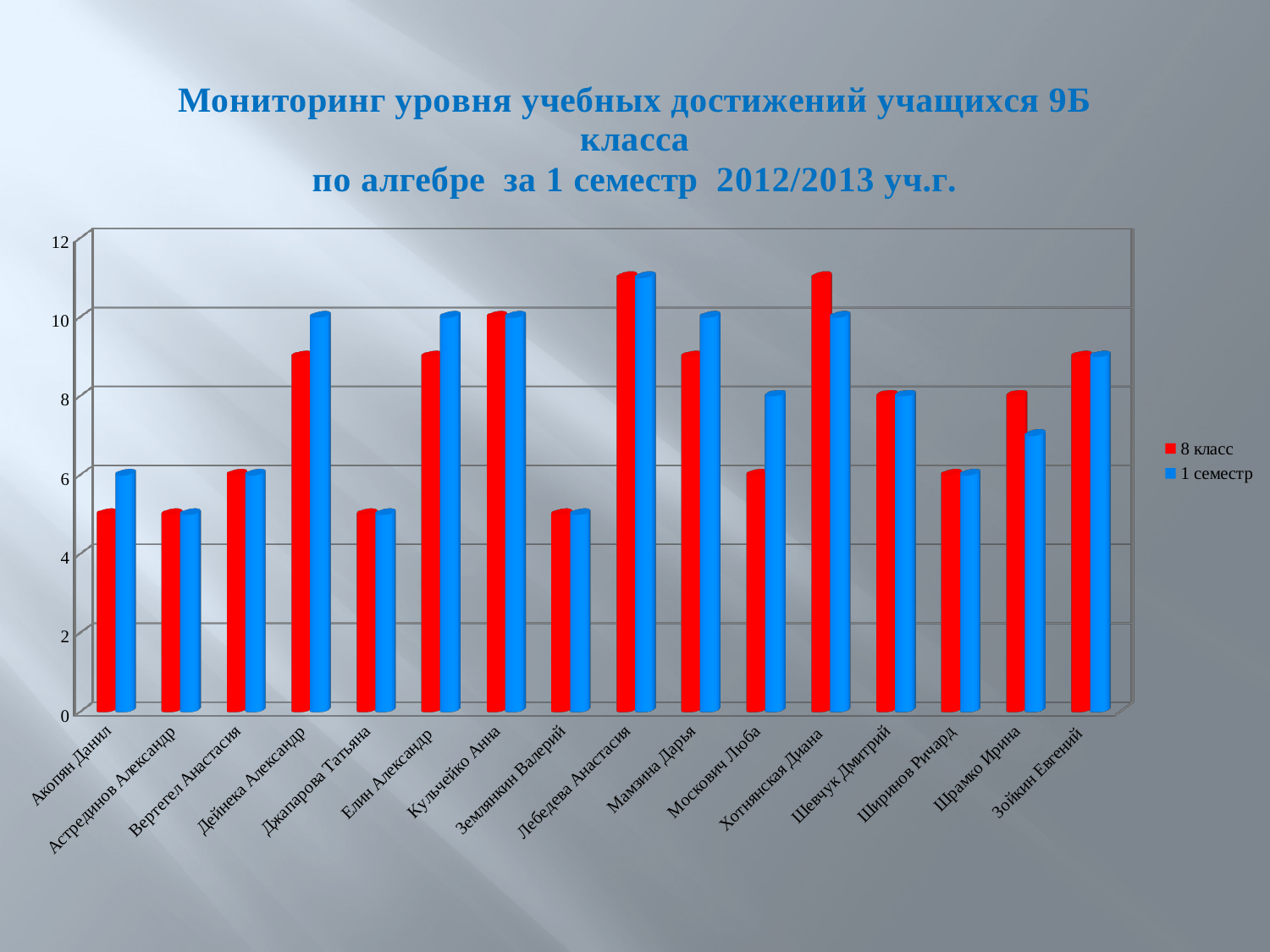
What is the value for Кульчейко Анна in the 8 класс series? 10 What kind of chart is shown on the slide? bar chart How many students (categories) are shown on the x axis? 16 What is the value for Москович Люба in the 1 семестр series? 8 Is the value for Лебедева Анастасия in the 8 класс series greater or less than 10? greater How many series does the legend list? 2 Is the value for Акопян Данил in the 8 класс series greater or less than 6? less What is the value for Шевчук Дмитрий in the 8 класс series? 8 What is the value for Дейнека Александр in the 1 семестр series? 10 Which student has the highest value in the 1 семестр series? Лебедева Анастасия For Москович Люба, which series has the larger value, 8 класс or 1 семестр? 1 семестр Which colour represents the 8 класс series in the legend? red